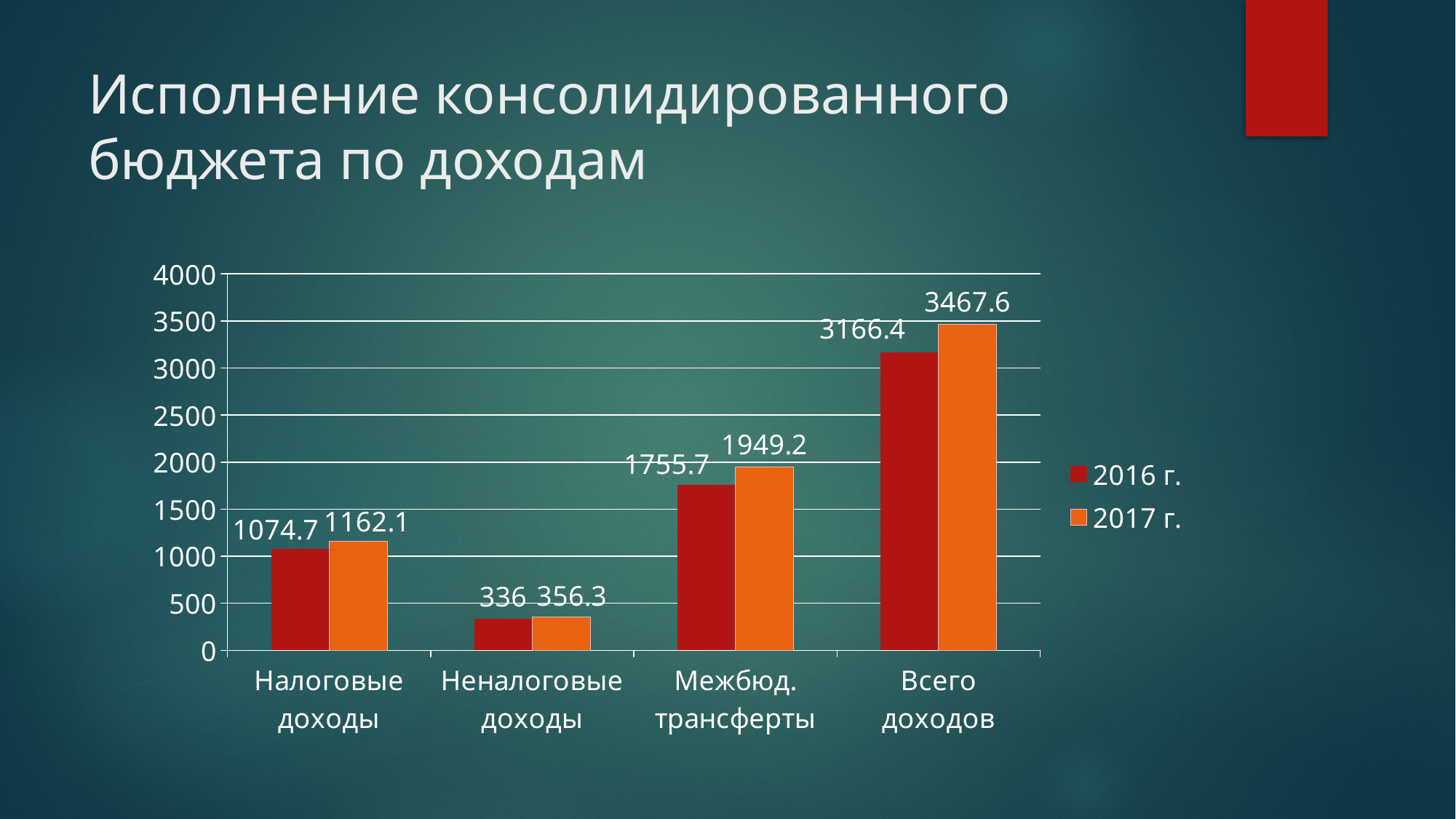
What is the value for Налоговые доходы in the 2016 г. series? 1074.7 What is the difference between the 2017 г. and 2016 г. values for Всего доходов? 301.2 Which category has the lowest value in the 2016 г. series? Неналоговые доходы Which category has the highest value in the 2017 г. series? Всего доходов What is the value for Межбюд. трансферты in the 2017 г. series? 1949.2 Which colour represents the 2017 г. series? orange How many series does the legend list? 2 Is the 2016 г. value for Межбюд. трансферты greater or less than 1500? greater What kind of chart is shown on the slide? bar chart What is the value for Неналоговые доходы in the 2016 г. series? 336 Which is larger for Налоговые доходы: the 2016 г. value or the 2017 г. value? 2017 г. How many categories are shown on the x axis? 4